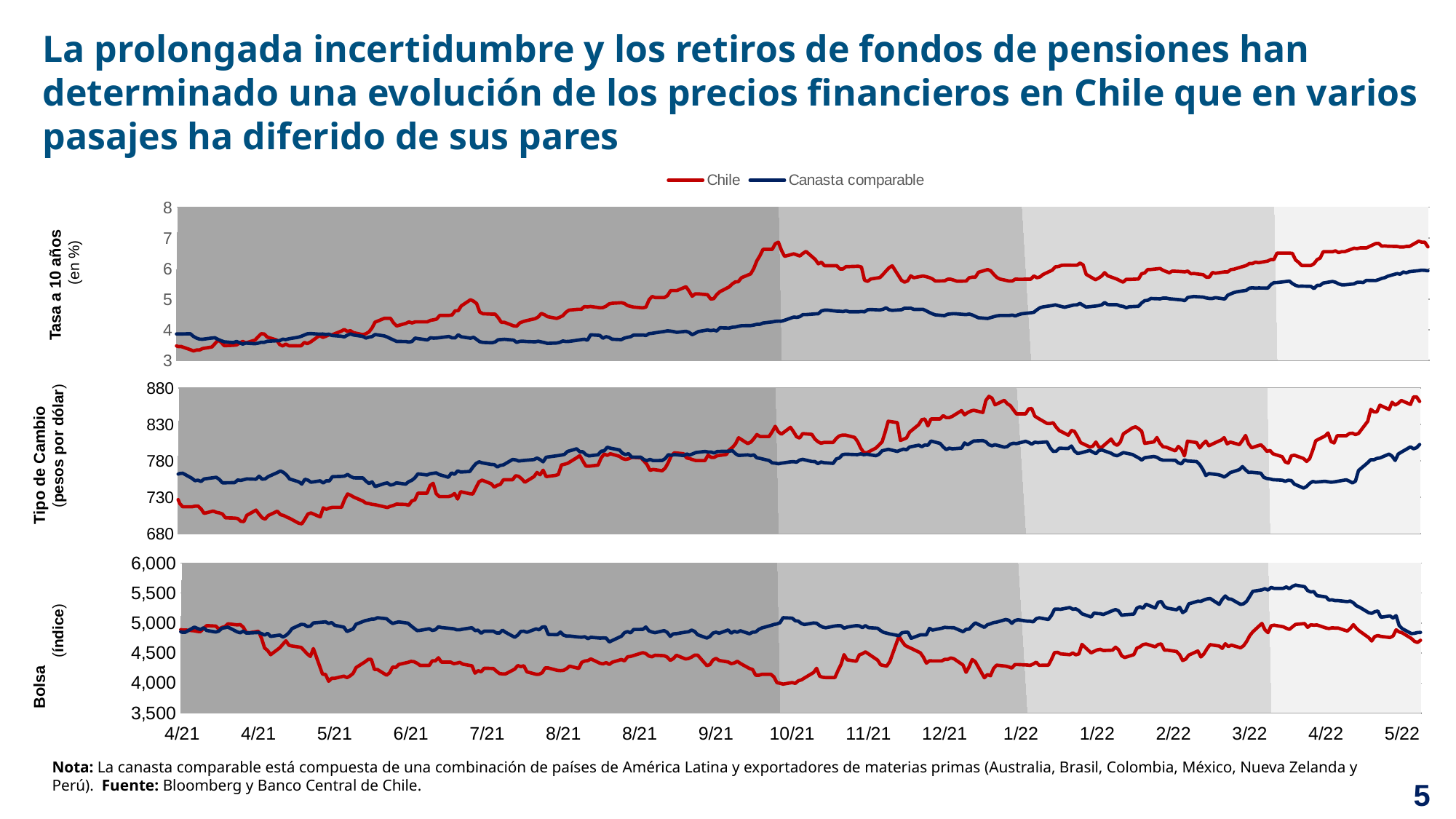
In the Tasa a 10 años panel, does the Chile series rise or fall overall from 4/21 to 5/22? rise In the Tasa a 10 años panel, is the value for Canasta comparable at 10/21 greater or less than 5? less How many series does the legend list? 2 What are the two series named in the legend? Chile and Canasta comparable What kind of chart is used in the three panels on the slide? line chart In the Tipo de Cambio panel, is the value for Chile at 5/22 greater or less than 830? greater In the Bolsa panel, is the value for Chile at 10/21 greater or less than 4,500? less In the Tasa a 10 años panel, which series is higher at 5/22, Chile or Canasta comparable? Chile In the Bolsa panel, does the Canasta comparable series rise or fall from 4/22 to 5/22? fall In the Bolsa panel, which series is higher at 4/22, Chile or Canasta comparable? Canasta comparable